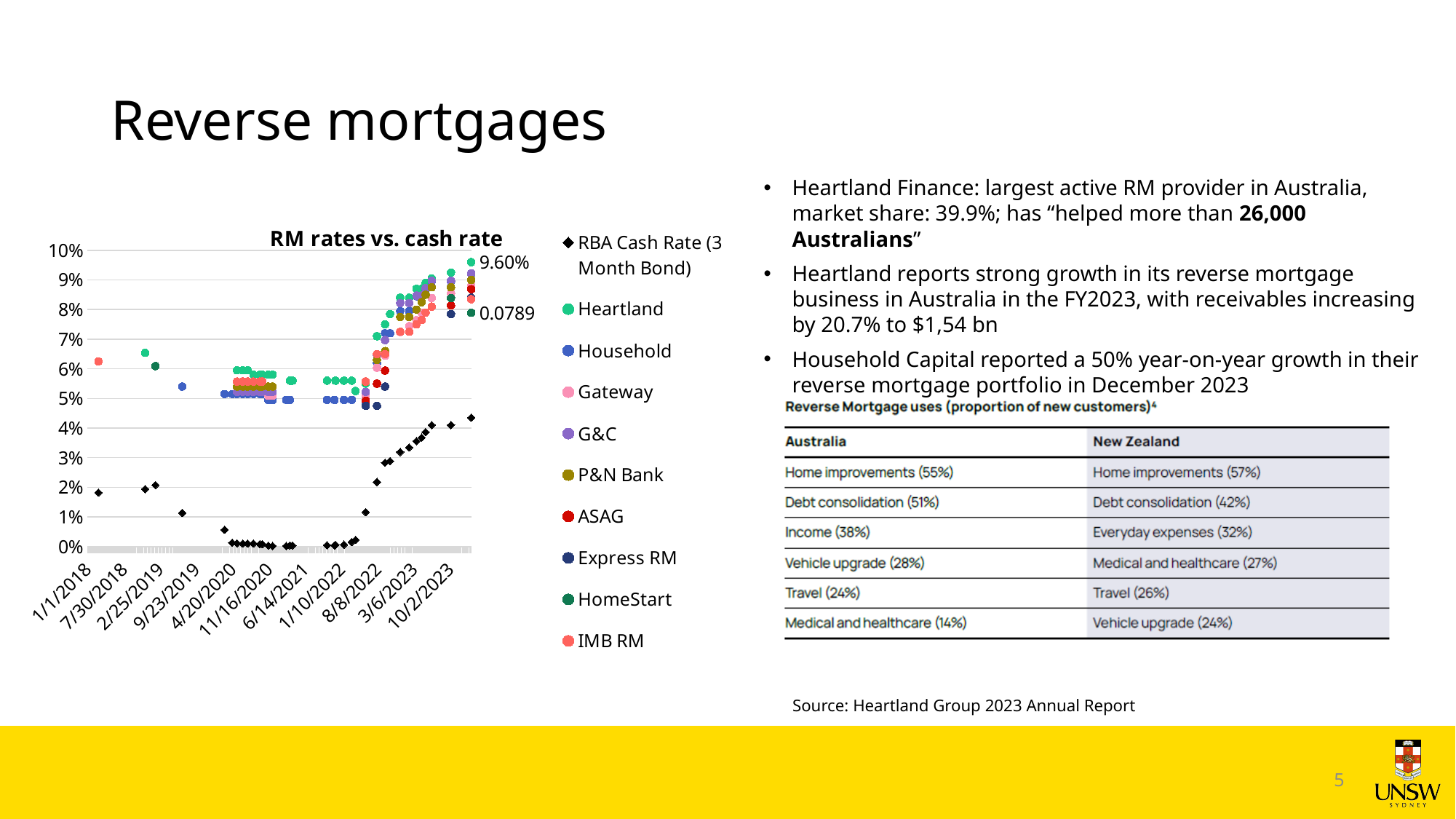
In the 'RM rates vs. cash rate' chart, which series is plotted lowest across the whole period? RBA Cash Rate (3 Month Bond) How many series does the legend of the 'RM rates vs. cash rate' chart list? 10 In the 'RM rates vs. cash rate' chart, is the RBA Cash Rate around 6/14/2021 greater or less than 1%? less What is the title of the chart on the slide? RM rates vs. cash rate What kind of chart is 'RM rates vs. cash rate'? scatter chart In the 'RM rates vs. cash rate' chart, which series has the highest rate at the most recent date? Heartland In the 'RM rates vs. cash rate' chart, what value is labelled on the latest HomeStart data point? 0.0789 In the 'RM rates vs. cash rate' chart, is the RBA Cash Rate at the most recent date greater or less than 4%? greater In the 'RM rates vs. cash rate' chart, is the latest Heartland rate larger or the latest HomeStart rate larger? Heartland In the 'RM rates vs. cash rate' chart, does the RBA Cash Rate rise or fall from 8/8/2022 to 10/2/2023? rise In the 'RM rates vs. cash rate' chart, what value is labelled on the latest Heartland data point? 9.60% In the 'RM rates vs. cash rate' chart, which series is shown with black diamond markers? RBA Cash Rate (3 Month Bond)